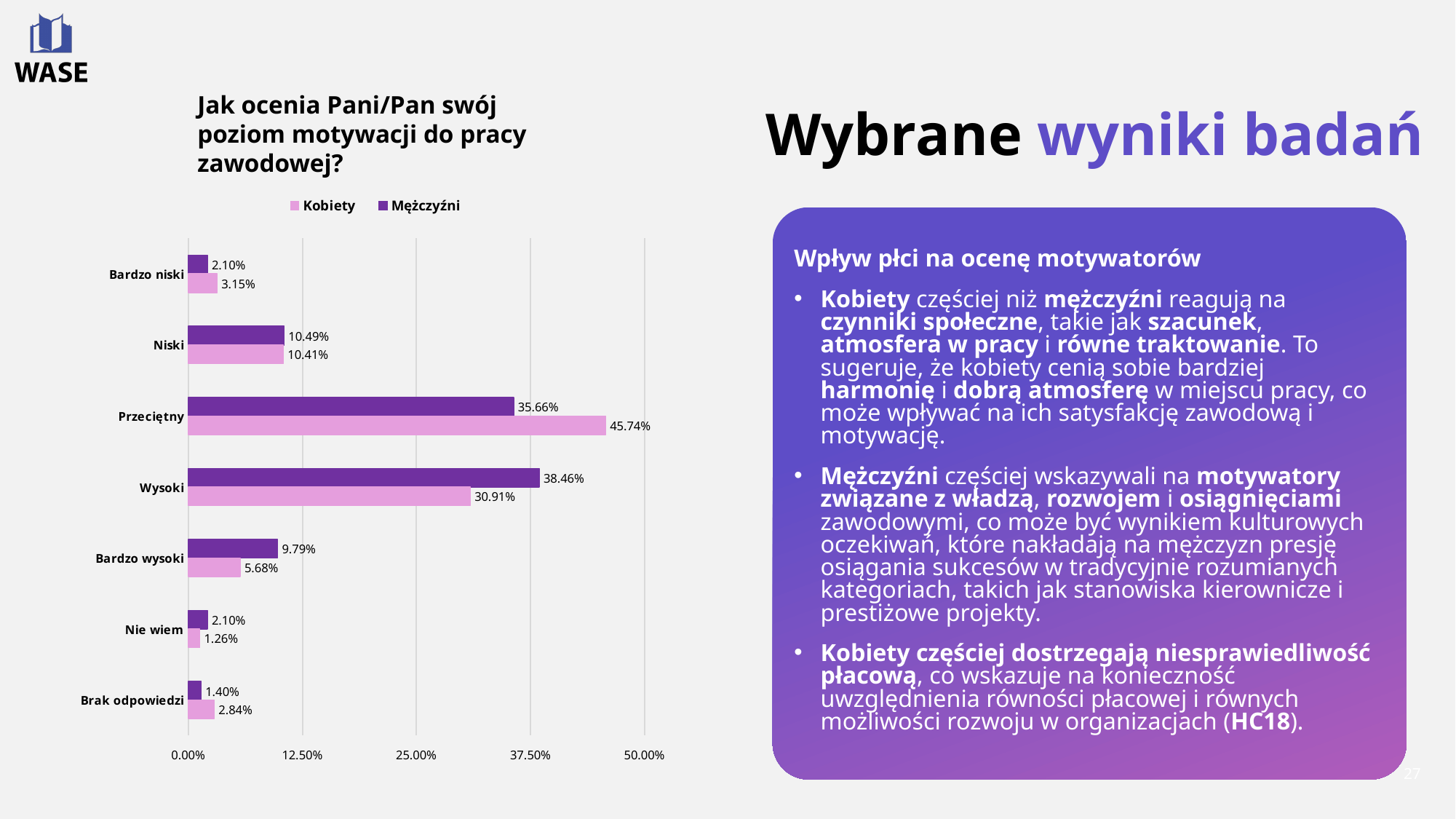
What is the value for Mężczyźni in the Wysoki category? 38.46% What is the value for Kobiety in the Bardzo wysoki category? 5.68% How many series does the chart legend list? 2 What type of chart is shown on the slide? Bar chart What is the difference between the Kobiety and Mężczyźni values in the Przeciętny category? 10.08% What is the value for Kobiety in the Przeciętny category? 45.74% Which category has the highest value for Mężczyźni? Wysoki How many categories are shown on the chart? 7 Which category has the highest value for Kobiety? Przeciętny Which category has the lowest value for Kobiety? Nie wiem What is the title of the chart? Jak ocenia Pani/Pan swój poziom motywacji do pracy zawodowej? In the Wysoki category, which series has the larger value, Kobiety or Mężczyźni? Mężczyźni